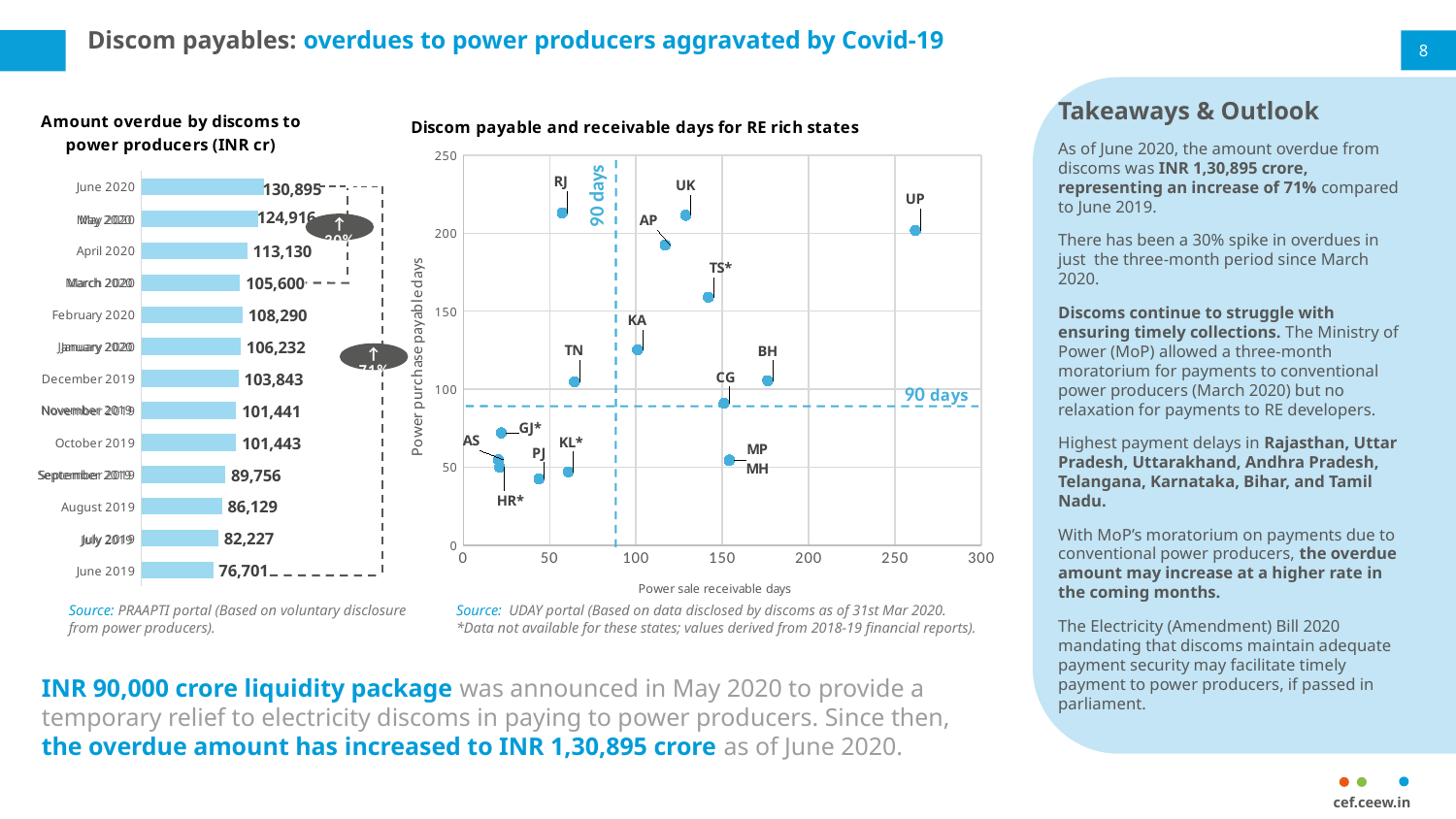
In the 'Amount overdue by discoms to power producers (INR cr)' chart, which month has the highest overdue amount? June 2020 In the 'Discom payable and receivable days for RE rich states' chart, are the power sale receivable days for UP greater or less than 200? greater What kind of chart is the 'Discom payable and receivable days for RE rich states' chart? Scatter chart In the 'Amount overdue by discoms to power producers (INR cr)' chart, which is larger, the value for February 2020 or March 2020? February 2020 In the 'Amount overdue by discoms to power producers (INR cr)' chart, what is the value for June 2020? 130,895 In the 'Amount overdue by discoms to power producers (INR cr)' chart, what is the value for March 2020? 105,600 In the 'Amount overdue by discoms to power producers (INR cr)' chart, what is the value for June 2019? 76,701 In the 'Amount overdue by discoms to power producers (INR cr)' chart, what is the difference between the June 2020 and June 2019 values? 54,194 In the 'Amount overdue by discoms to power producers (INR cr)' chart, which month has the lowest overdue amount? June 2019 How many months are shown in the 'Amount overdue by discoms to power producers (INR cr)' chart? 13 What kind of chart is the 'Amount overdue by discoms to power producers (INR cr)' chart? Bar chart In the 'Discom payable and receivable days for RE rich states' chart, are the power purchase payable days for MP greater or less than 100? less